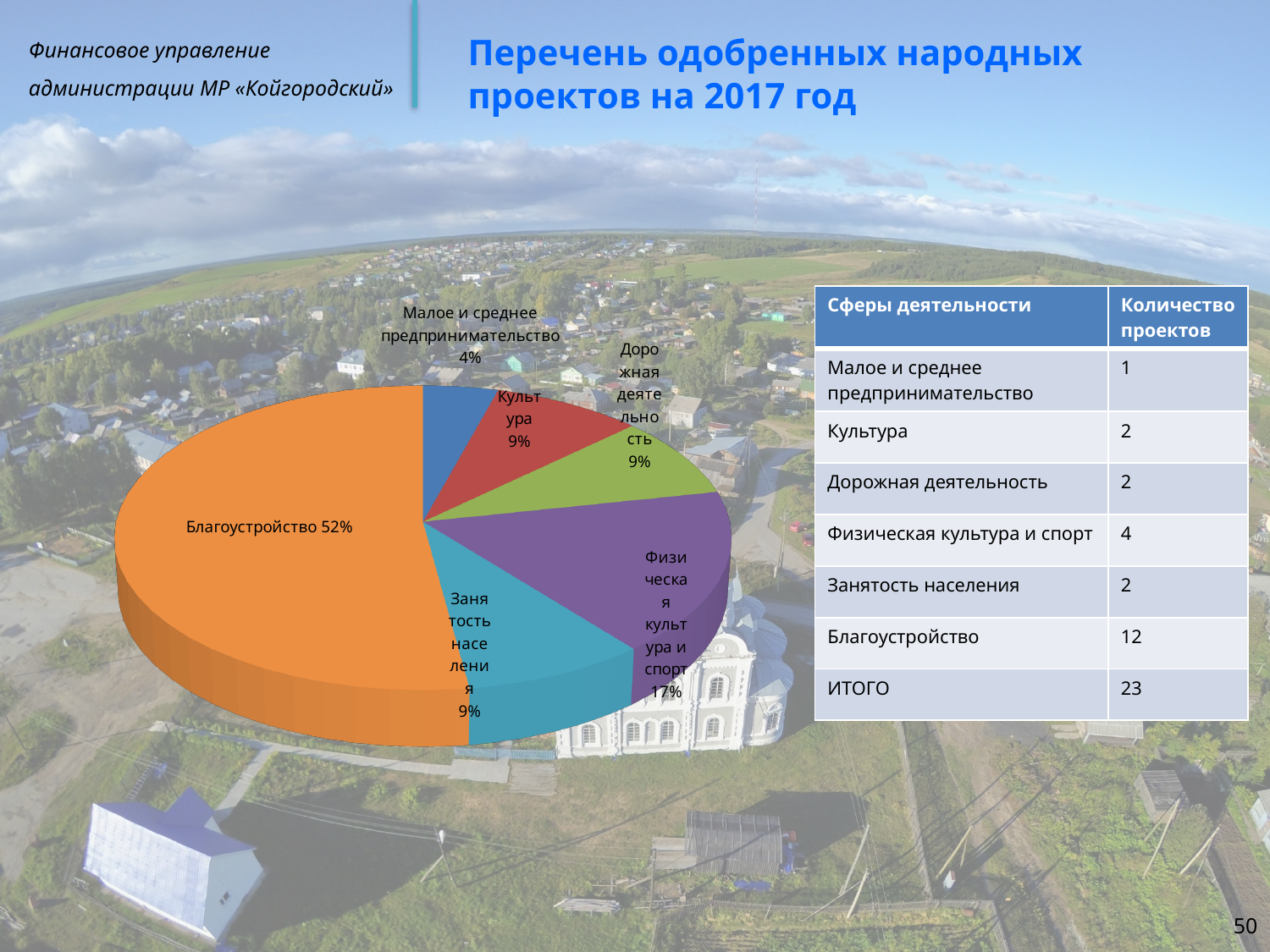
What share of the pie does Малое и среднее предпринимательство take? 4% What share of the pie does Культура take? 9% Which is larger in the pie chart: Физическая культура и спорт or Дорожная деятельность? Физическая культура и спорт Which slice of the pie chart is the smallest? Малое и среднее предпринимательство What share of the pie does Благоустройство take? 52% What colour is the Благоустройство slice in the pie chart? Orange How many slices does the pie chart have? 6 What kind of chart is shown on the slide? Pie chart Which slice of the pie chart is the largest? Благоустройство What is the difference in percentage points between Благоустройство and Физическая культура и спорт? 35